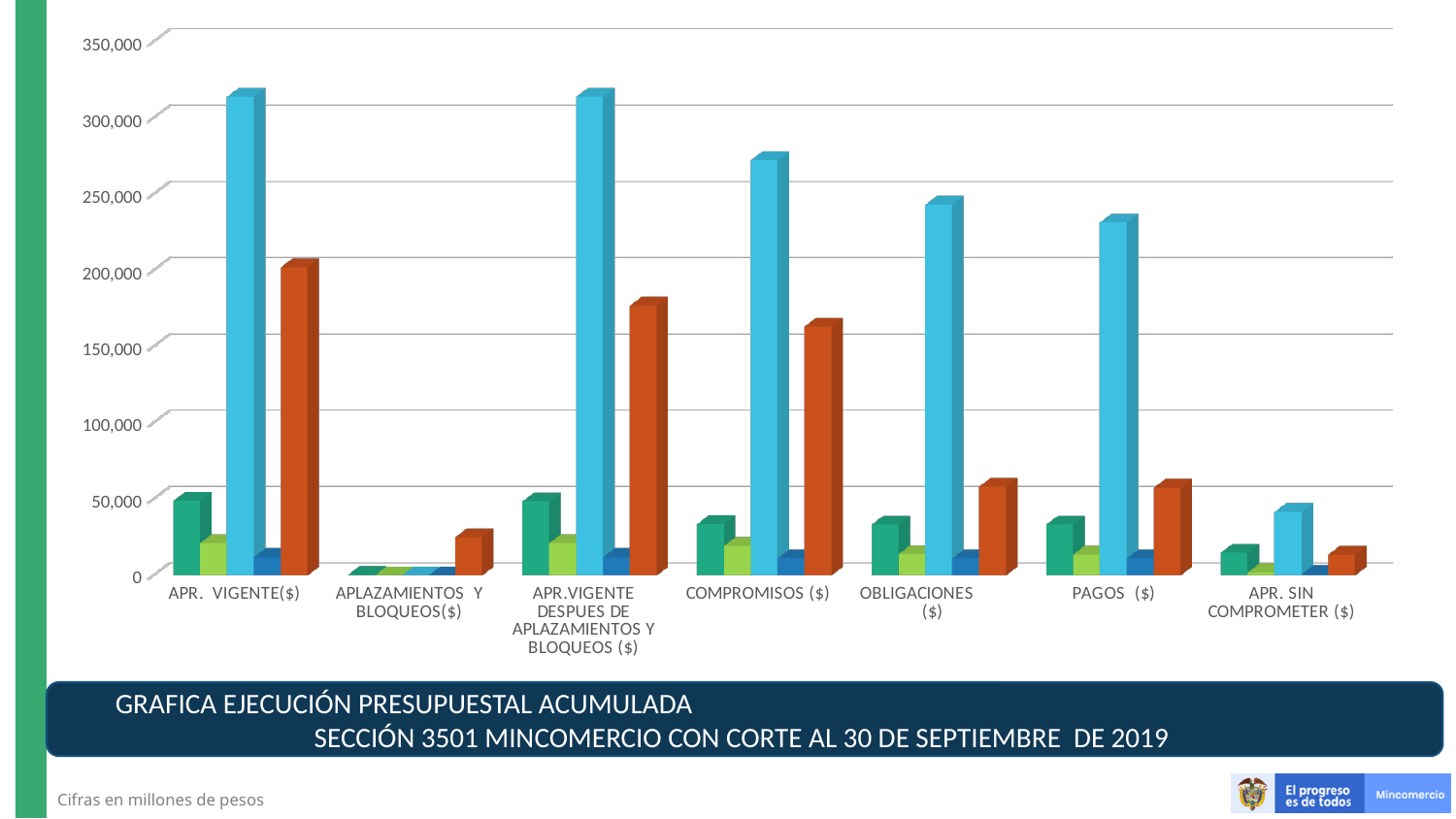
According to the note at the bottom of the slide, in what units are the figures expressed? Millones de pesos Is the orange bar for APR.VIGENTE DESPUES DE APLAZAMIENTOS Y BLOQUEOS ($) greater or less than 150,000? greater Which has the larger light blue bar, COMPROMISOS ($) or OBLIGACIONES ($)? COMPROMISOS ($) Is the light blue bar for APR. VIGENTE($) greater or less than 300,000? greater How many categories are shown along the x axis of the chart? 7 Which category has the lowest light blue bar? APLAZAMIENTOS Y BLOQUEOS($) Is the light blue bar for COMPROMISOS ($) greater or less than 250,000? greater Which category has the highest orange bar? APR. VIGENTE($) What kind of chart is shown on the slide? Bar chart Do the light blue bars rise or fall from COMPROMISOS ($) to PAGOS ($)? fall